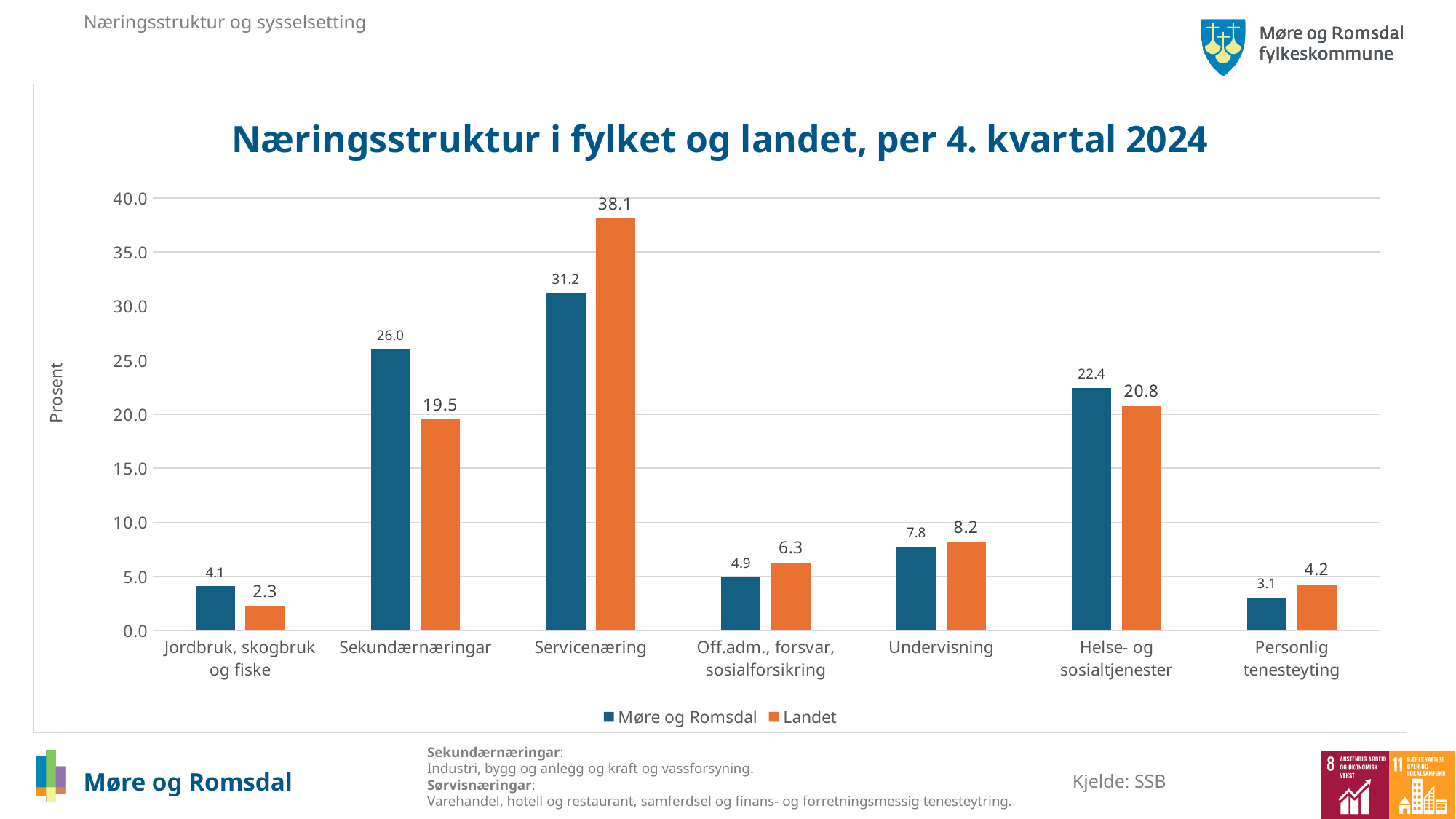
Which category has the highest value for Landet? Servicenæring What is the title of the chart? Næringsstruktur i fylket og landet, per 4. kvartal 2024 Which is larger in Helse- og sosialtjenester: Møre og Romsdal or Landet? Møre og Romsdal What is the difference between Landet and Møre og Romsdal in Servicenæring? 6.9 How many categories are shown on the x axis? 7 How many series does the legend list? 2 What kind of chart is shown on the slide? Bar chart What is the value for Møre og Romsdal in Servicenæring? 31.2 What is the difference between Møre og Romsdal and Landet in Sekundærnæringar? 6.5 What is the value for Landet in Personlig tenesteyting? 4.2 Which category has the lowest value for Møre og Romsdal? Personlig tenesteyting What is the value for Landet in Sekundærnæringar? 19.5